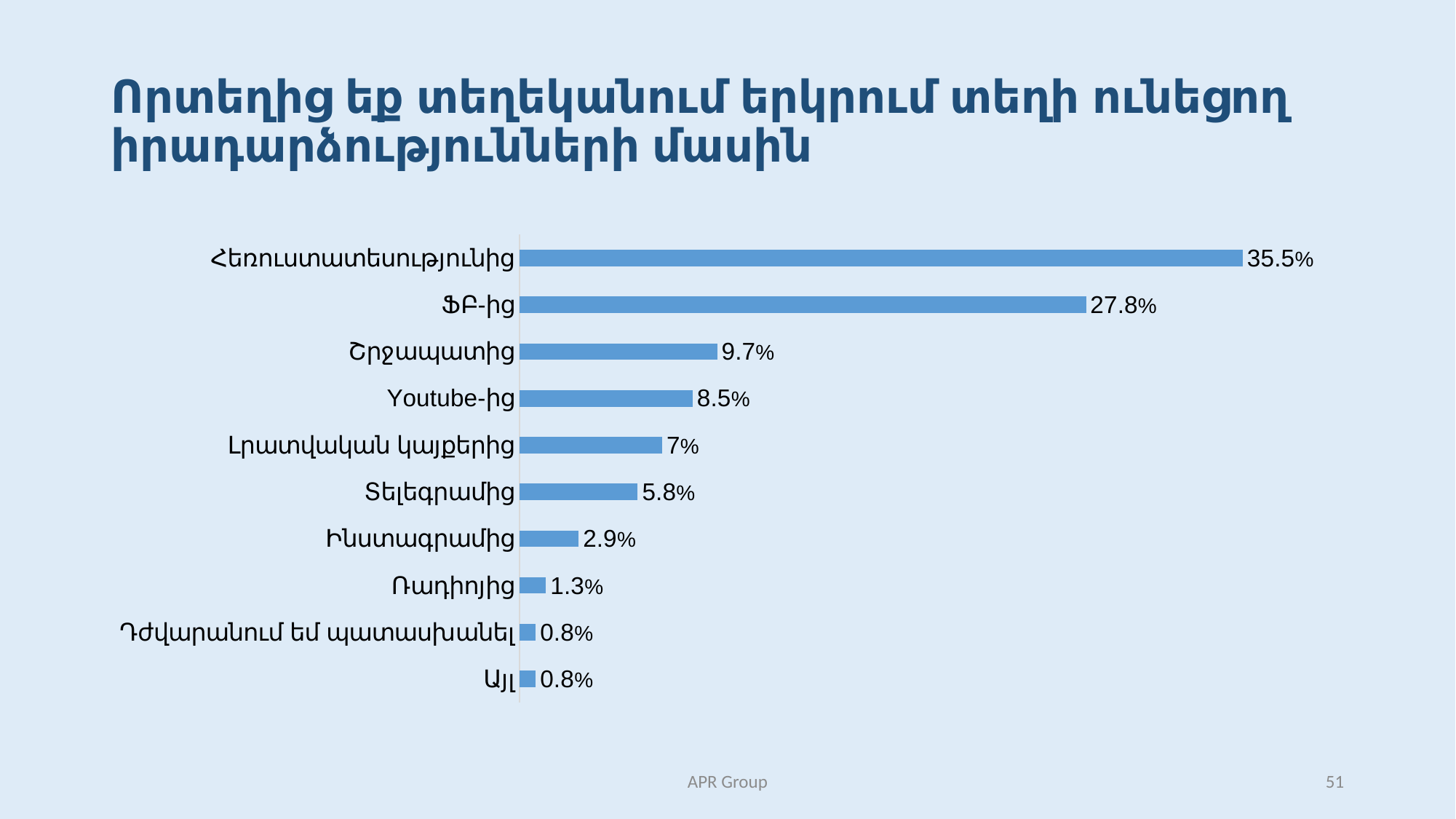
Which two categories share the lowest value of 0.8%? Դժվարանում եմ պատասխանել and Այլ What is the difference between the values for Շրջապատից and Youtube-ից? 1.2% Which category has the highest value? Հեռուստատեսությունից What is the value for Youtube-ից? 8.5% What kind of chart is shown on the slide? Bar chart What is the value for Տելեգրամից? 5.8% How many categories are shown in the chart? 10 What is the value for Հեռուստատեսությունից? 35.5% What is the value for Ռադիոյից? 1.3% Which is larger, the value for Լրատվական կայքերից or the value for Ինստագրամից? Լրատվական կայքերից What is the difference between the values for Հեռուստատեսությունից and ՖԲ-ից? 7.7% What colour are the bars in the chart? Blue